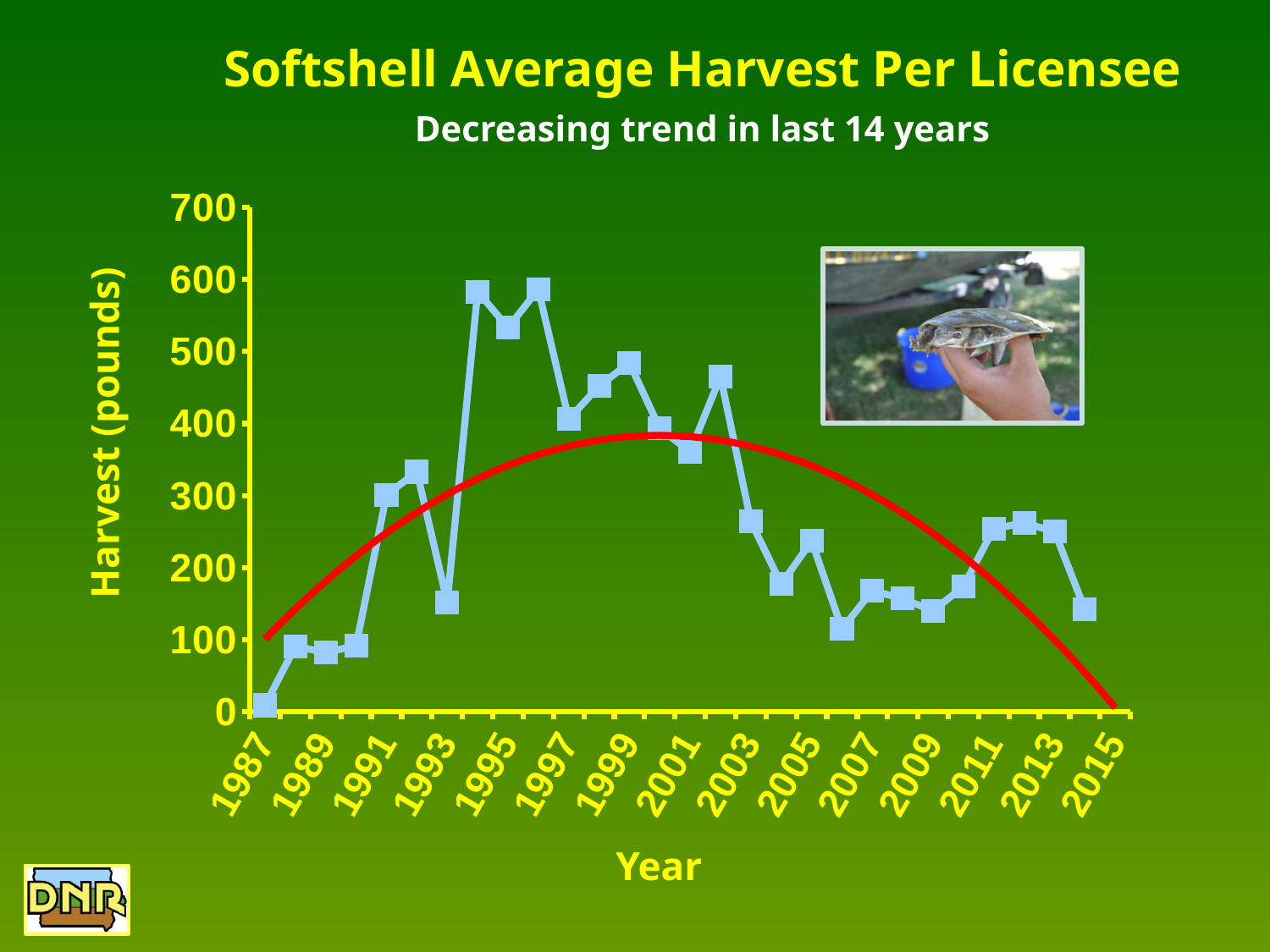
What is the label of the vertical axis? Harvest (pounds) Is the value for 2012 greater or less than 200? greater Is the value for 2006 greater or less than 200? less Is the value for 1987 greater or less than 100? less Which year has the larger harvest per licensee, 1994 or 2006? 1994 According to the subtitle, what is the trend in the last 14 years? Decreasing What type of chart is shown on the slide? line chart What is the title of the chart? Softshell Average Harvest Per Licensee Which year has the lowest harvest per licensee? 1987